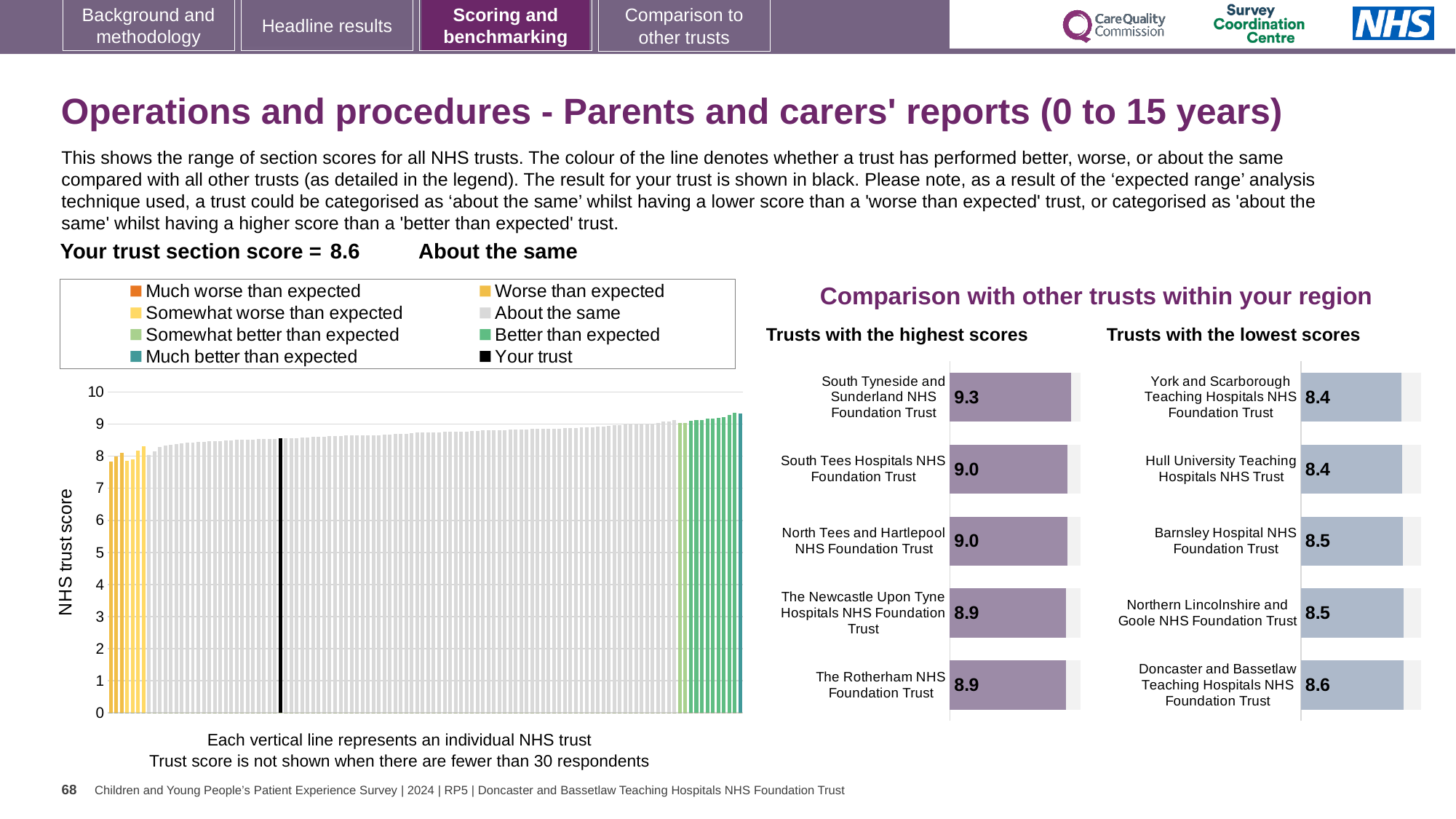
In the 'Trusts with the lowest scores' chart, what is the score for Doncaster and Bassetlaw Teaching Hospitals NHS Foundation Trust? 8.6 In the 'Trusts with the highest scores' chart, which trust has the highest score? South Tyneside and Sunderland NHS Foundation Trust In the large chart on the left, is the value for the black 'Your trust' bar greater or less than 8? greater Which is larger: the score for South Tees Hospitals NHS Foundation Trust in the 'highest scores' chart or the score for York and Scarborough Teaching Hospitals NHS Foundation Trust in the 'lowest scores' chart? South Tees Hospitals NHS Foundation Trust How many trusts are shown in the 'Trusts with the highest scores' chart? 5 In the 'Trusts with the highest scores' chart, what is the score for South Tyneside and Sunderland NHS Foundation Trust? 9.3 In the 'Trusts with the highest scores' chart, what is the difference between the scores of South Tyneside and Sunderland NHS Foundation Trust and The Rotherham NHS Foundation Trust? 0.4 In the 'Trusts with the highest scores' chart, what is the score for The Rotherham NHS Foundation Trust? 8.9 In the 'Trusts with the lowest scores' chart, what is the difference between the scores of Doncaster and Bassetlaw Teaching Hospitals NHS Foundation Trust and Hull University Teaching Hospitals NHS Trust? 0.2 In the 'Trusts with the lowest scores' chart, which trust has the highest score shown? Doncaster and Bassetlaw Teaching Hospitals NHS Foundation Trust In the 'Trusts with the lowest scores' chart, what is the score for Barnsley Hospital NHS Foundation Trust? 8.5 What kind of chart is the large chart on the left showing NHS trust scores? Bar chart